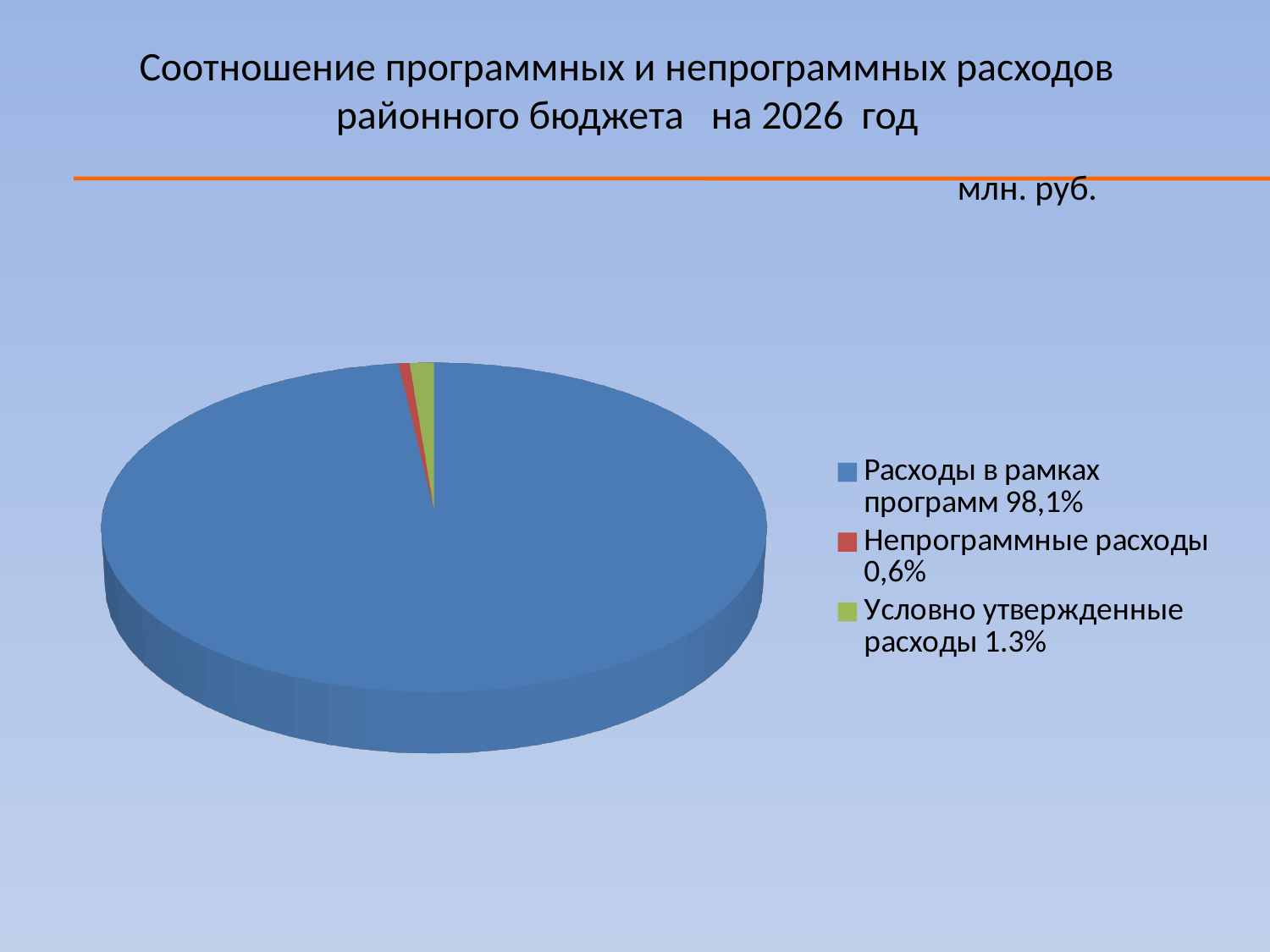
Which category has the smallest slice of the pie? Непрограммные расходы What is the title of the chart on the slide? Соотношение программных и непрограммных расходов районного бюджета на 2026 год What share of the pie is labelled for "Расходы в рамках программ"? 98,1% Which category has the largest slice of the pie? Расходы в рамках программ How many entries does the legend list? 3 Which is larger: the share for "Условно утвержденные расходы" or the share for "Непрограммные расходы"? Условно утвержденные расходы What share of the pie is labelled for "Непрограммные расходы"? 0,6% What is the difference between the share for "Условно утвержденные расходы" and the share for "Непрограммные расходы"? 0,7% How many slices does the pie chart have? 3 What share of the pie is labelled for "Условно утвержденные расходы"? 1.3% What kind of chart is shown on the slide? pie chart What colour is the slice for "Расходы в рамках программ"? blue